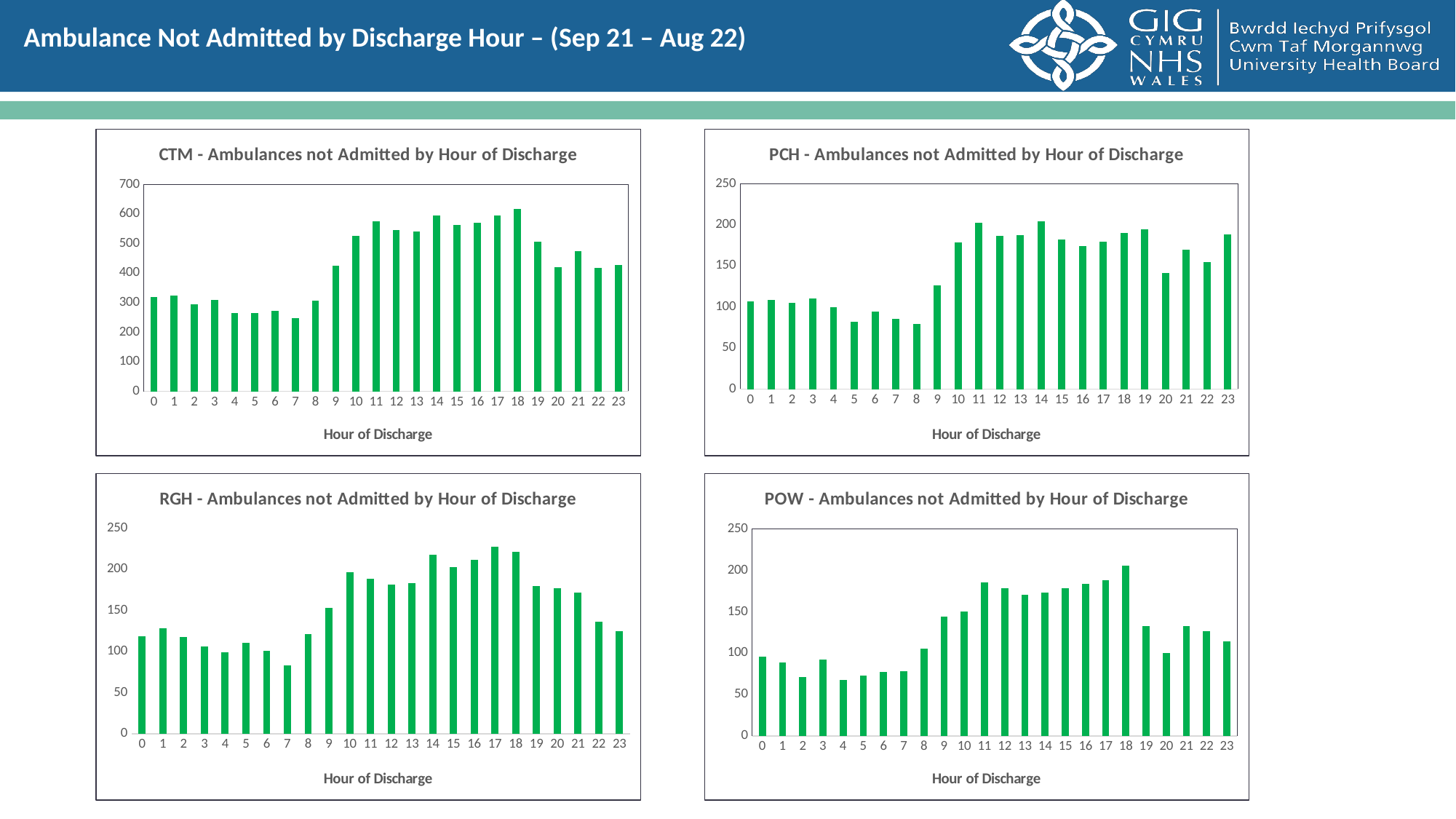
In the CTM - Ambulances not Admitted by Hour of Discharge chart, which hour of discharge has the highest value? 18 In the POW - Ambulances not Admitted by Hour of Discharge chart, which hour of discharge has the highest value? 18 In the PCH - Ambulances not Admitted by Hour of Discharge chart, is the value for hour 11 greater or less than 150? greater In the CTM - Ambulances not Admitted by Hour of Discharge chart, which hour of discharge has the lowest value? 7 What is the x-axis title on the POW - Ambulances not Admitted by Hour of Discharge chart? Hour of Discharge In the RGH - Ambulances not Admitted by Hour of Discharge chart, which is larger, the value for hour 10 or the value for hour 22? Hour 10 In the CTM - Ambulances not Admitted by Hour of Discharge chart, is the value for hour 4 greater or less than 300? less How many hour categories are plotted on the PCH - Ambulances not Admitted by Hour of Discharge chart? 24 What kind of chart is the CTM - Ambulances not Admitted by Hour of Discharge chart? Bar chart In the RGH - Ambulances not Admitted by Hour of Discharge chart, which hour of discharge has the lowest value? 7 In the POW - Ambulances not Admitted by Hour of Discharge chart, is the value for hour 5 greater or less than 100? less In the PCH - Ambulances not Admitted by Hour of Discharge chart, do the values rise or fall from hour 8 to hour 11? Rise